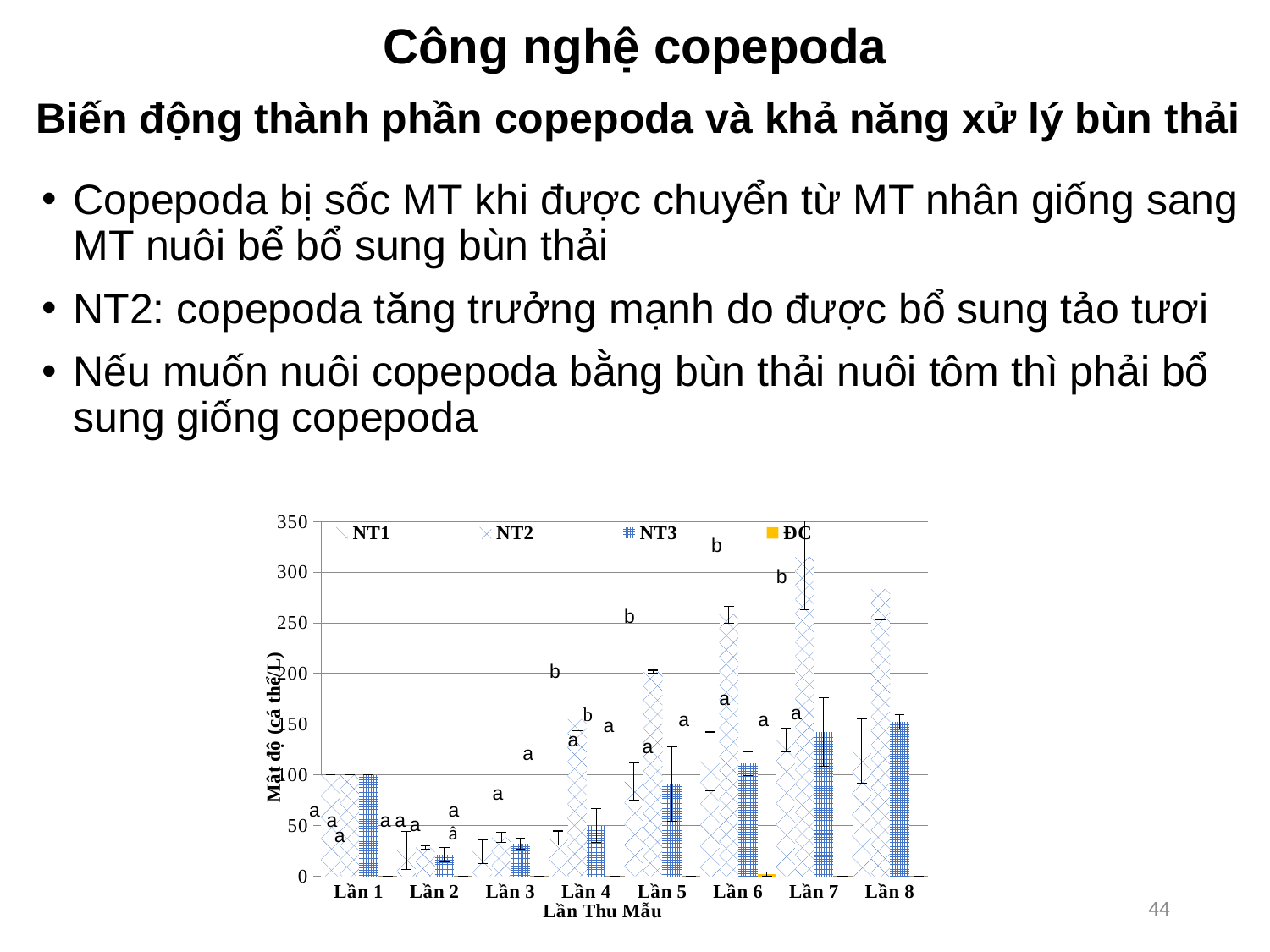
Does the NT2 series rise or fall from Lần 4 to Lần 7? rise Is the value for NT3 at Lần 2 greater or less than 50? less Is the value for NT2 at Lần 7 greater or less than 300? greater How many series does the chart legend list? 4 At Lần 5, which is larger, the NT2 bar or the NT3 bar? NT2 Is the value for NT2 at Lần 6 greater or less than 250? greater How many sampling categories (Lần) are shown on the x axis? 8 In which sampling round is the NT2 bar the highest? Lần 7 What is the title of the y axis? Mật độ (cá thể/L) What kind of chart is shown on the slide? bar chart Which series is shown in the legend with a solid orange/yellow fill? ĐC